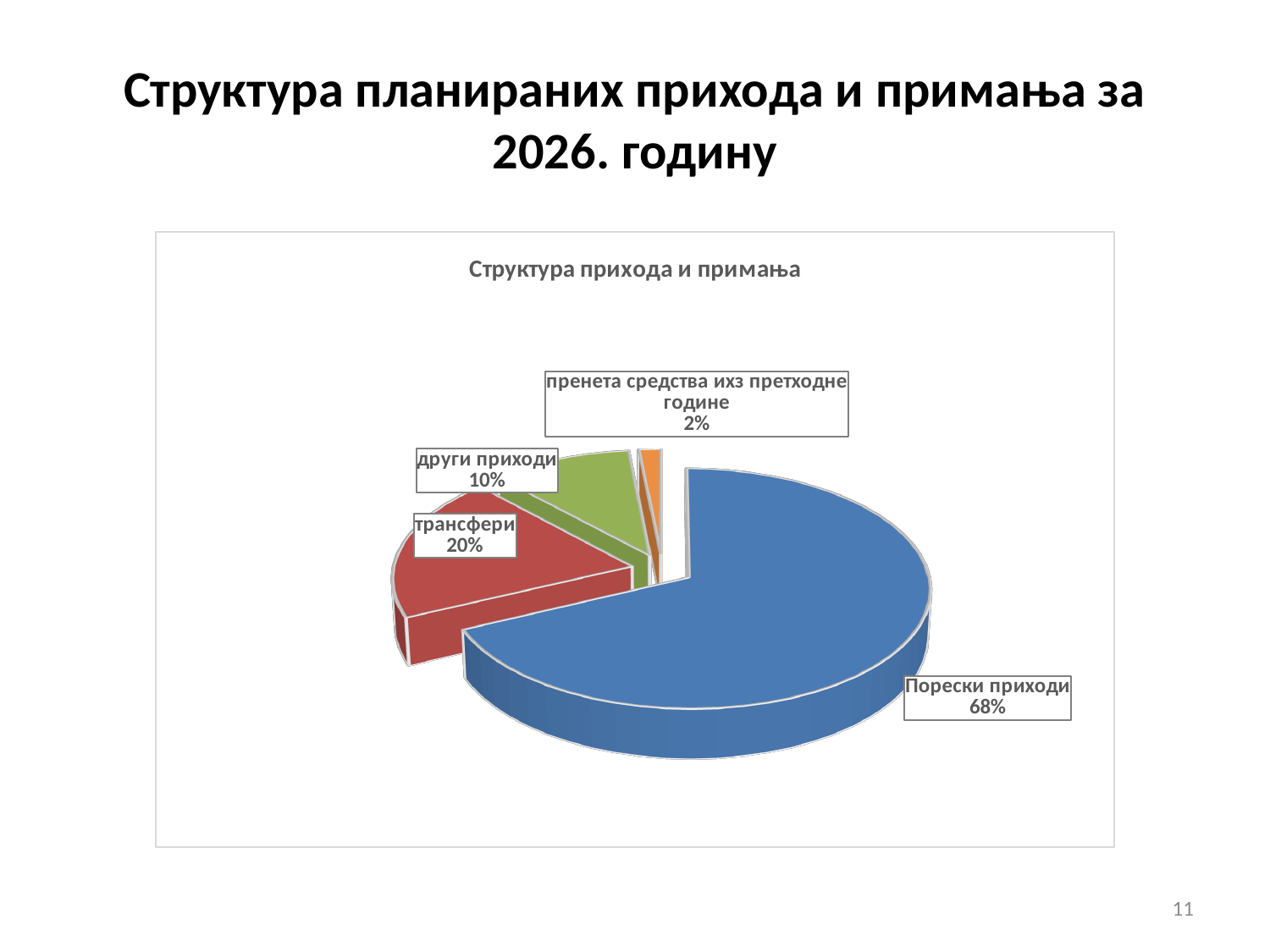
What is the difference in percentage points between Порески приходи and трансфери? 48 How many slices does the pie chart have? 4 What share of the pie does други приходи represent? 10% What is the title of the chart? Структура прихода и примања Which category has the smallest share of the pie? пренета средства ихз претходне године What share of the pie does трансфери represent? 20% What kind of chart is shown on the slide? pie chart What is the difference in percentage points between трансфери and други приходи? 10 Which is larger, the share for трансфери or the share for други приходи? трансфери What share of the pie does Порески приходи represent? 68% Which category has the largest share of the pie? Порески приходи